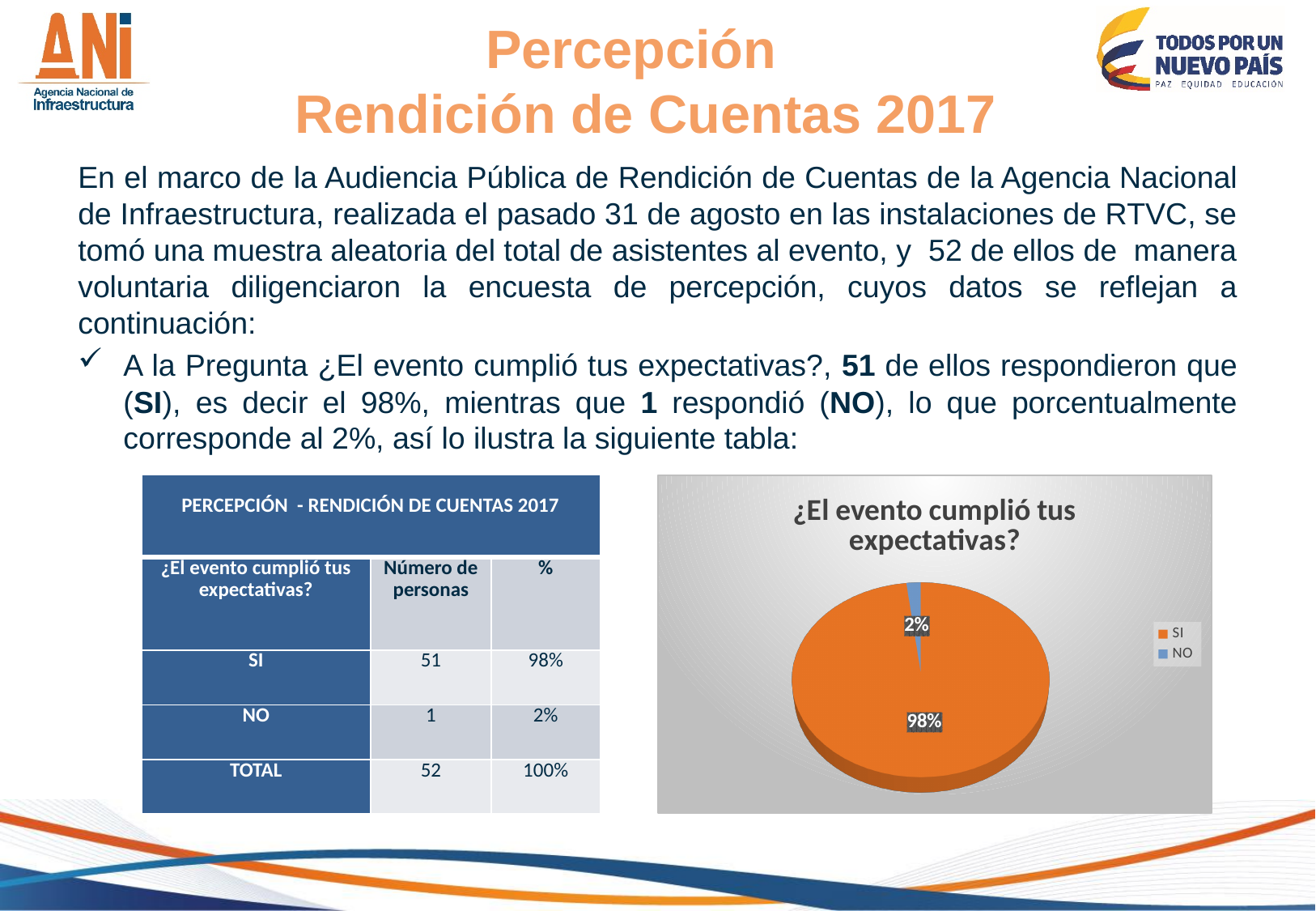
How many slices does the pie chart have? 2 What colour is the SI slice in the pie chart? orange What is the difference in percentage points between the SI and NO slices? 96 percentage points Which slice of the pie chart is the smallest? NO What is the title of the pie chart? ¿El evento cumplió tus expectativas? Which slice of the pie chart is the largest? SI What kind of chart is shown on the slide? pie chart What share of the pie does the SI slice represent? 98% How many series does the legend of the pie chart list? 2 What share of the pie does the NO slice represent? 2% Which is larger in the pie chart, SI or NO? SI